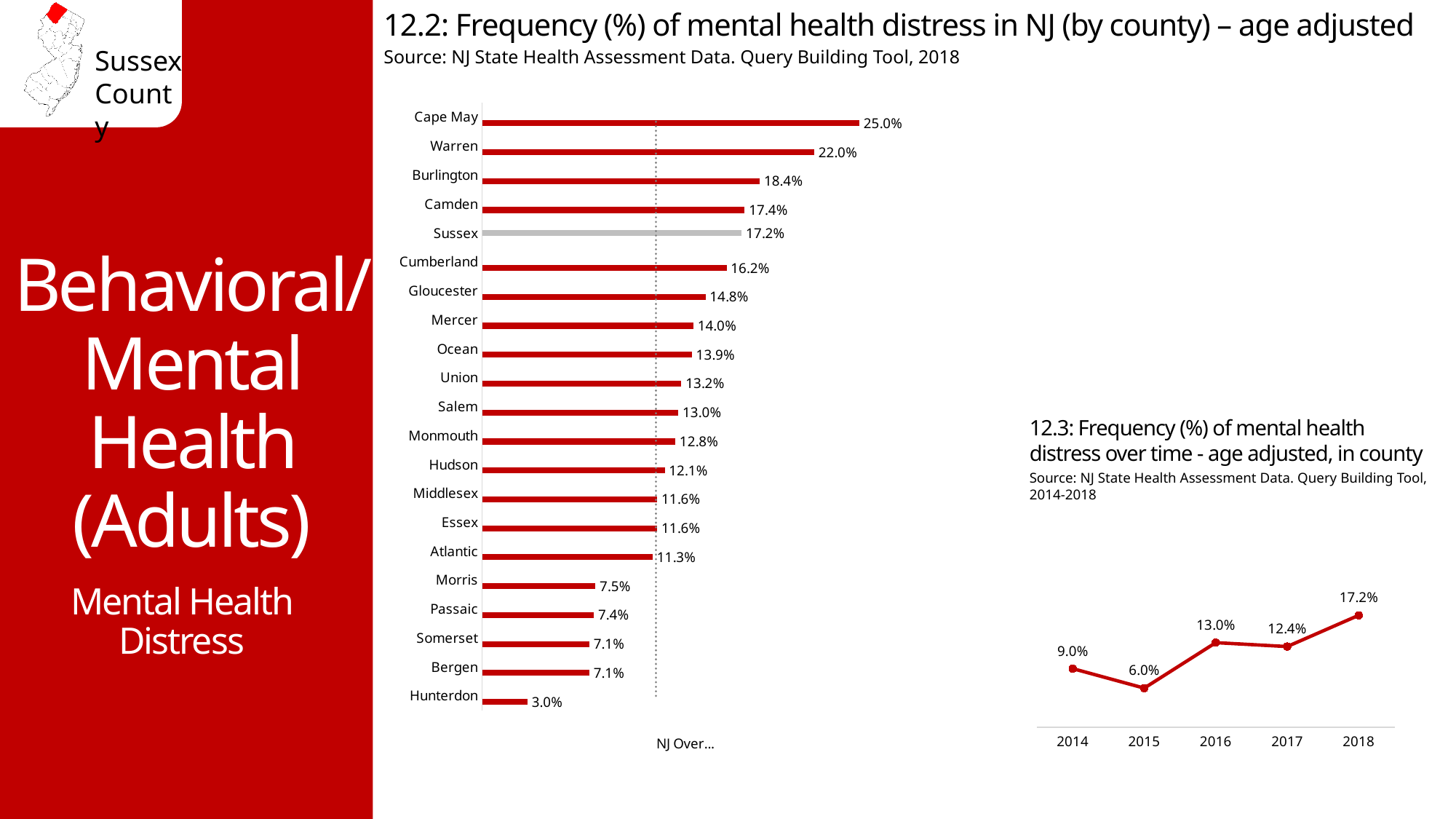
In chart 12.2 (mental health distress by county), how many counties are plotted? 21 What kind of chart is chart 12.3 (mental health distress over time)? Line chart In chart 12.3 (mental health distress over time), what is the value for 2015? 6.0% In chart 12.2 (mental health distress by county), what is the value for Morris? 7.5% In chart 12.2 (mental health distress by county), which county has the highest value? Cape May In chart 12.3 (mental health distress over time), what is the difference between the 2018 and 2014 values? 8.2% In chart 12.2 (mental health distress by county), what is the difference between Cape May and Warren? 3.0% What kind of chart is chart 12.2 (mental health distress by county)? Bar chart In chart 12.2 (mental health distress by county), which is larger, the value for Camden or the value for Cumberland? Camden In chart 12.2 (mental health distress by county), what is the value for Sussex? 17.2% In chart 12.3 (mental health distress over time), which year has the highest value? 2018 In chart 12.2 (mental health distress by county), which county has the lowest value? Hunterdon